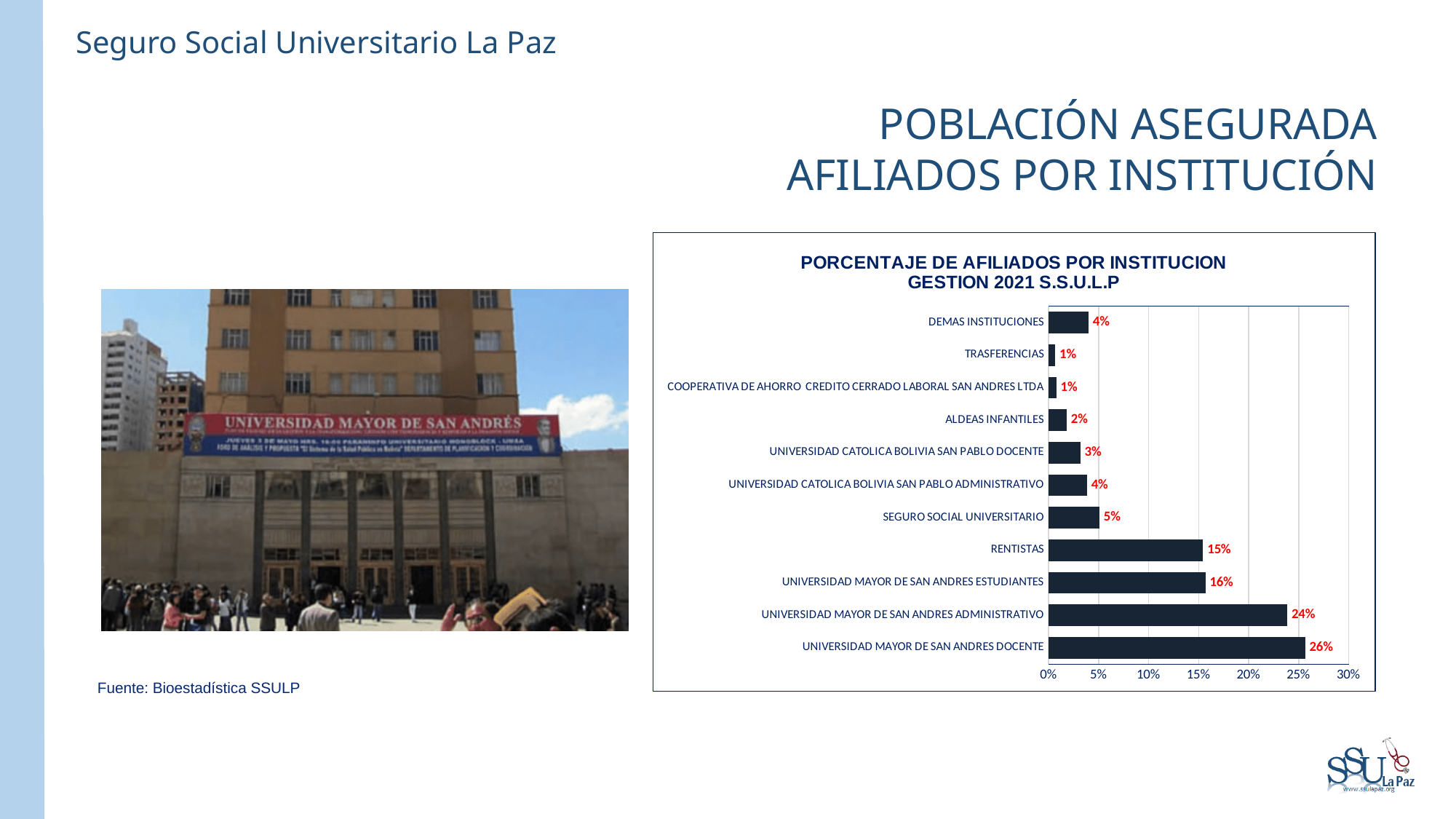
What percentage is shown for SEGURO SOCIAL UNIVERSITARIO? 5% What is the title of the chart? PORCENTAJE DE AFILIADOS POR INSTITUCION GESTION 2021 S.S.U.L.P What type of chart is shown on the slide? Bar chart What percentage of affiliates does UNIVERSIDAD MAYOR DE SAN ANDRES DOCENTE account for? 26% What is the difference between UNIVERSIDAD MAYOR DE SAN ANDRES ADMINISTRATIVO and UNIVERSIDAD MAYOR DE SAN ANDRES ESTUDIANTES? 8% Is the value for UNIVERSIDAD MAYOR DE SAN ANDRES ADMINISTRATIVO greater or less than 20%? greater How many institutions (categories) are shown in the chart? 11 Which is larger, RENTISTAS or UNIVERSIDAD MAYOR DE SAN ANDRES ESTUDIANTES? UNIVERSIDAD MAYOR DE SAN ANDRES ESTUDIANTES What is the value for ALDEAS INFANTILES? 2% What is the value shown for RENTISTAS? 15% What is the maximum value shown on the chart's horizontal axis? 30% Which institution has the highest percentage of affiliates? UNIVERSIDAD MAYOR DE SAN ANDRES DOCENTE